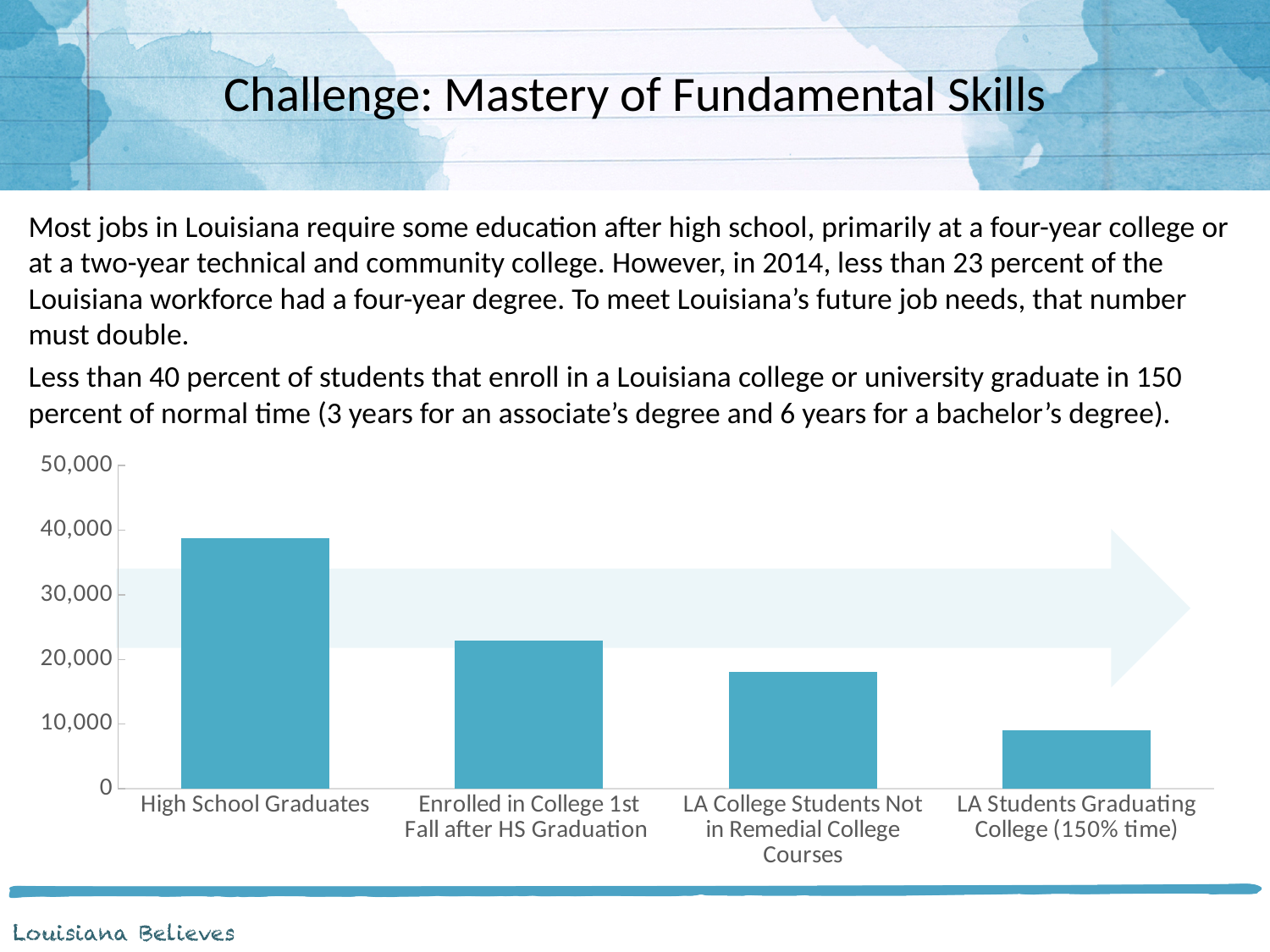
How many categories are plotted on the chart? 4 What is the highest value shown on the vertical axis? 50,000 Is the value for Enrolled in College 1st Fall after HS Graduation greater or less than 30,000? less Which category has the highest value on the chart? High School Graduates Is the value for LA Students Graduating College (150% time) greater or less than 20,000? less What kind of chart is shown on the slide? bar chart Which is larger: the value for Enrolled in College 1st Fall after HS Graduation or the value for LA College Students Not in Remedial College Courses? Enrolled in College 1st Fall after HS Graduation Is the value for High School Graduates greater or less than 30,000? greater Which category has the lowest value on the chart? LA Students Graduating College (150% time) Do the values rise or fall moving from left to right across the categories? fall What is the label of the first category on the left of the chart? High School Graduates